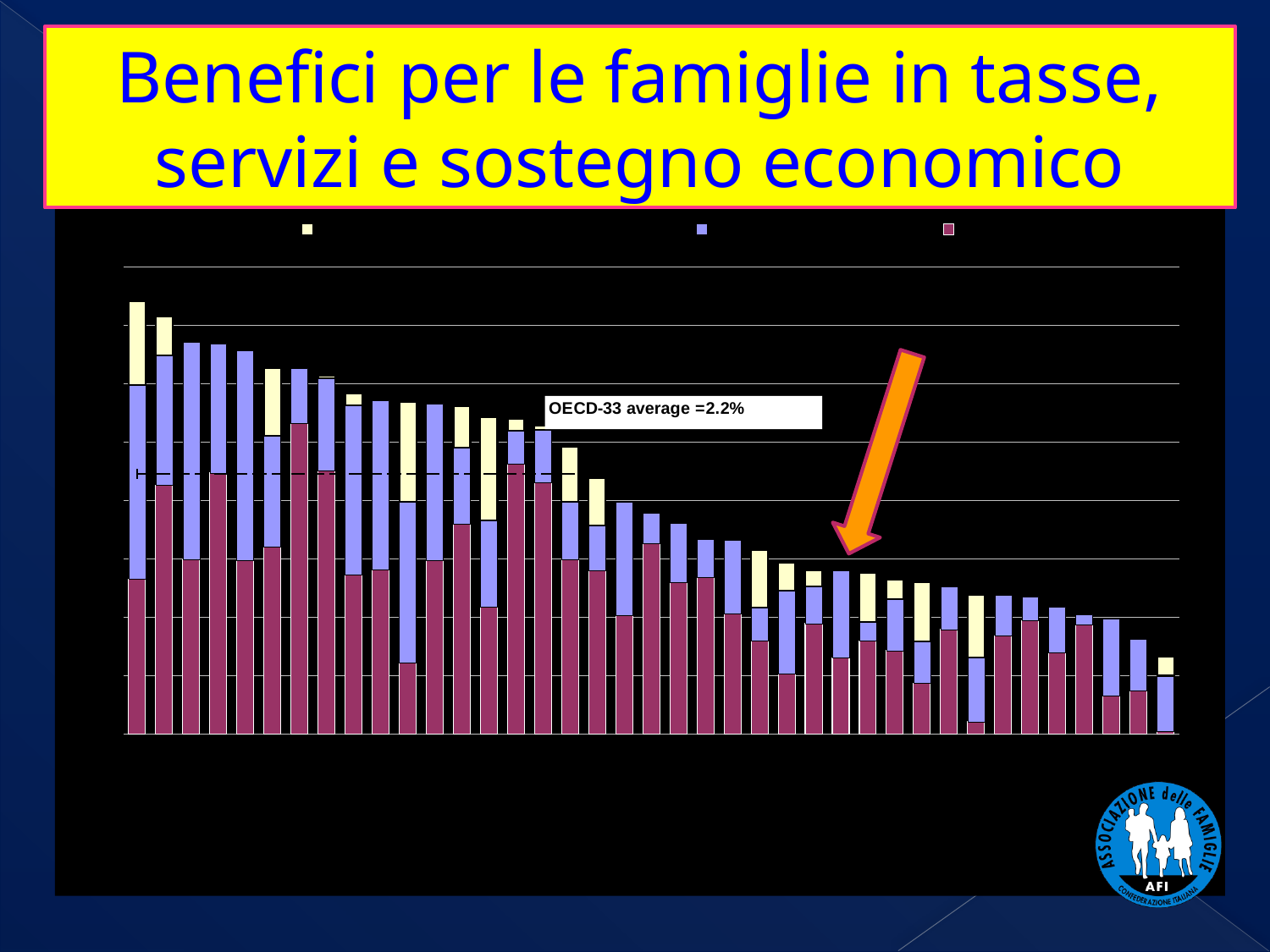
Do the total bar heights generally rise or fall from left to right along the x axis? fall What value does the annotation on the chart give for the OECD-33 average? 2.2% What text is written in the annotation box on the chart? OECD-33 average =2.2% What kind of chart is shown on the slide? stacked bar chart How many series does the legend of the chart list? 3